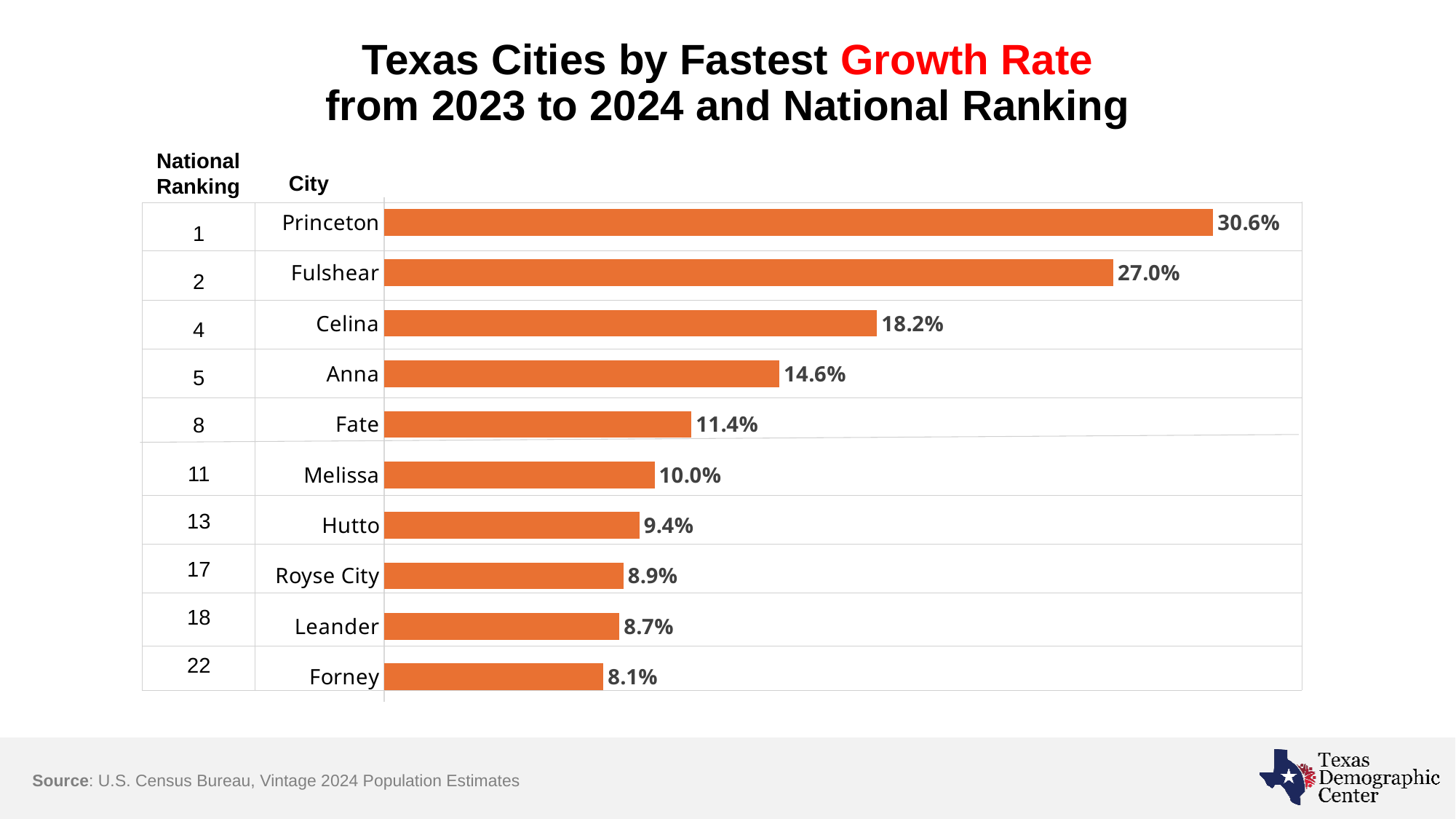
How many cities are shown on the chart? 10 Which city has the highest growth rate on the chart? Princeton Which city has the lowest growth rate on the chart? Forney What is the growth rate shown for Princeton? 30.6% What is the difference in growth rate between Princeton and Fulshear? 3.6% What is the growth rate shown for Hutto? 9.4% What is the source cited for the chart data? U.S. Census Bureau, Vintage 2024 Population Estimates What kind of chart is shown on the slide? Bar chart What is the difference in growth rate between Celina and Fate? 6.8% What national ranking is listed for Leander? 18 Which city has a higher growth rate, Melissa or Royse City? Melissa What is the growth rate shown for Anna? 14.6%